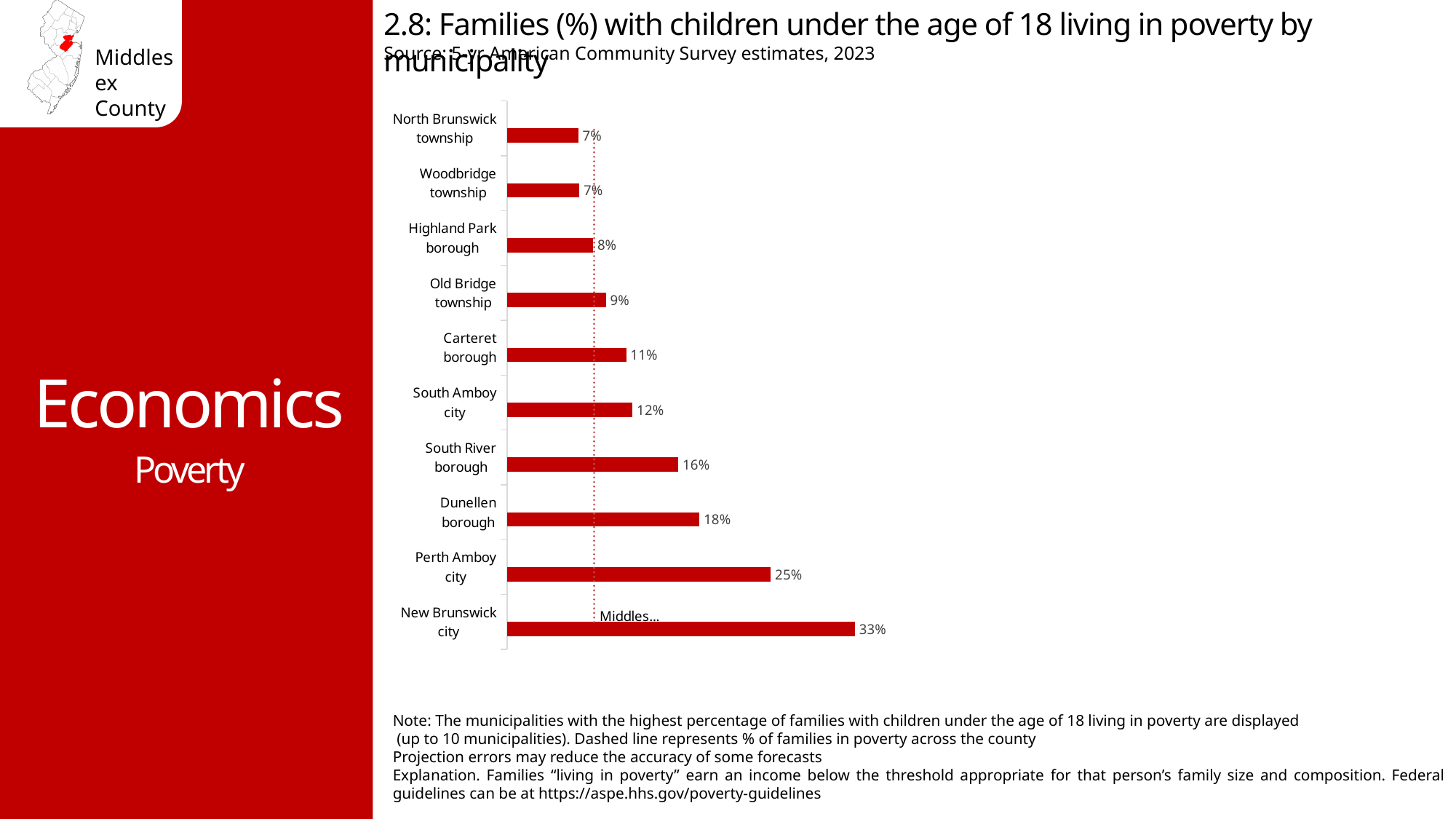
According to the note, what does the dashed line on the chart represent? % of families in poverty across the county Which municipality has the lowest value shown on the chart? North Brunswick township and Woodbridge township (both 7%) What is the value shown for Old Bridge township? 9% What is the difference between the values for New Brunswick city and Perth Amboy city? 8% How many municipalities are shown on the chart? 10 What is the value shown for South River borough? 16% Which municipality has the highest percentage of families with children under 18 living in poverty? New Brunswick city What is the value shown for Perth Amboy city? 25% Which has a higher value, South Amboy city or Highland Park borough? South Amboy city What percentage of families with children under 18 live in poverty in New Brunswick city? 33% What kind of chart is shown on the slide? Bar chart What is the difference between the values for Dunellen borough and Carteret borough? 7%